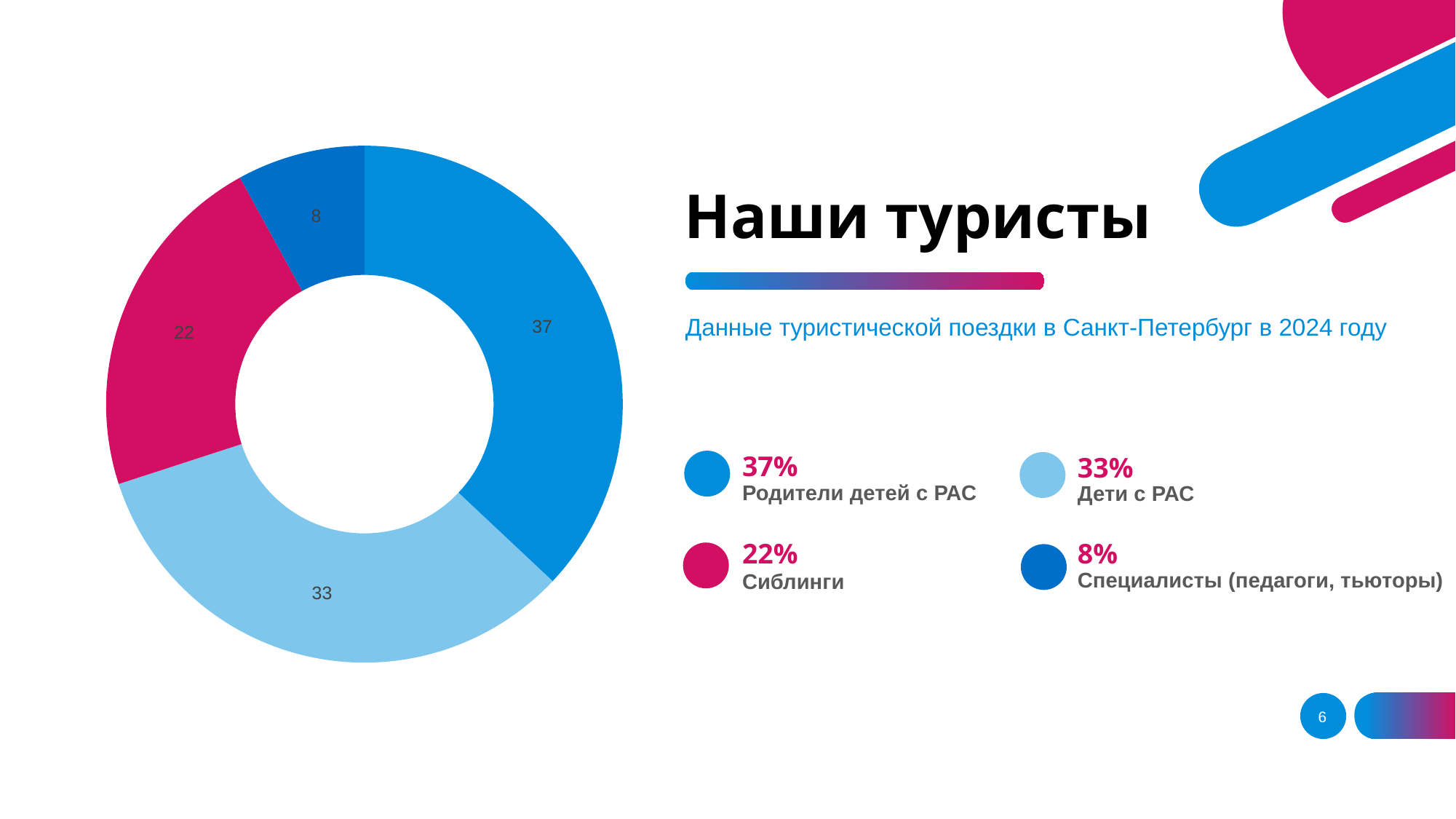
How many segments does the doughnut chart have? 4 Which category has the largest segment? Родители детей с РАС What is the data label for the Специалисты (педагоги, тьюторы) segment? 8 What kind of chart is shown on the slide? Doughnut chart Which category has the smallest segment? Специалисты (педагоги, тьюторы) Which is larger, the value for Дети с РАС or the value for Сиблинги? Дети с РАС What colour is the Сиблинги segment? Magenta (pink-red) What is the data label for the Сиблинги segment? 22 What is the difference between the values for Родители детей с РАС and Сиблинги? 15 What is the data label for the Дети с РАС segment? 33 What share of the chart does Сиблинги represent according to the legend? 22% What is the data label for the Родители детей с РАС segment? 37